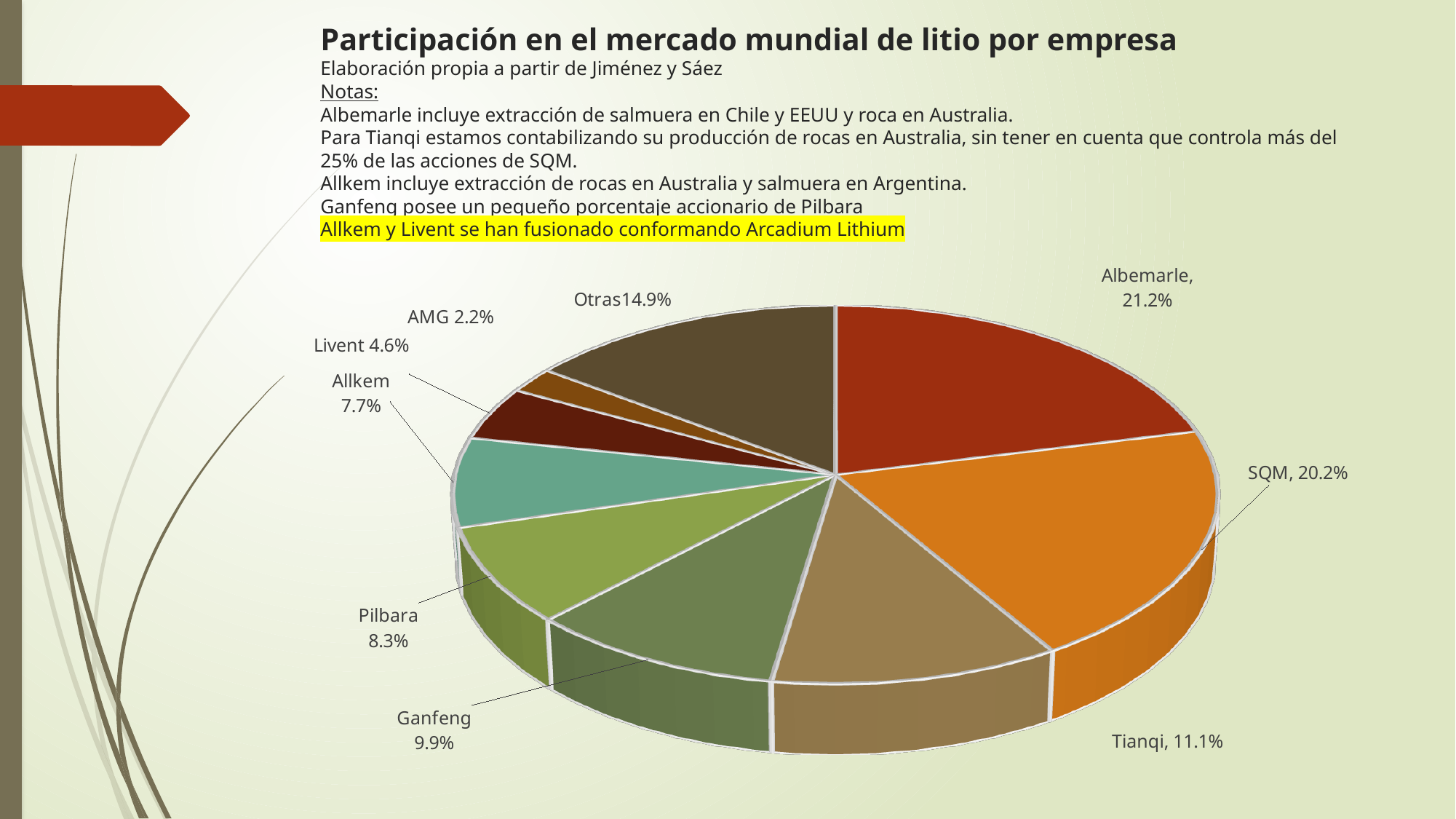
What share of the world lithium market does Albemarle hold according to the pie chart? 21.2% How many slices does the pie chart have? 9 What type of chart is shown on the slide? Pie chart What is the title of the slide containing the chart? Participación en el mercado mundial de litio por empresa What share does Ganfeng have in the pie chart? 9.9% Which is larger, the share for Pilbara or the share for Allkem? Pilbara What percentage is labelled for Tianqi on the pie chart? 11.1% Which slice of the pie chart is the smallest? AMG Which company has the largest slice of the pie chart? Albemarle What is the value shown for the 'Otras' slice? 14.9% What is the market share shown for SQM? 20.2% What is the difference between Albemarle's share and SQM's share? 1.0%